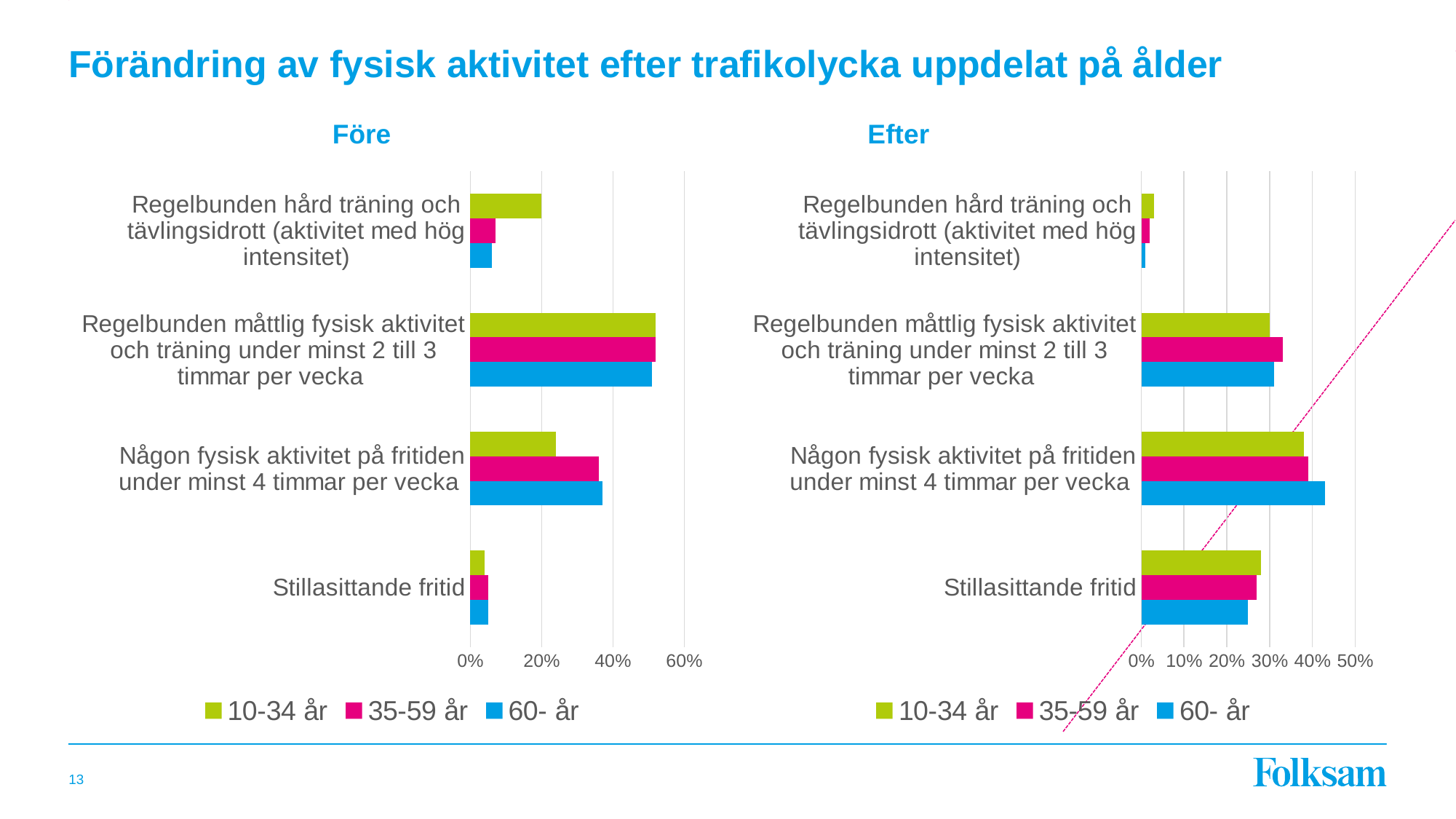
In the "Före" chart, which category has the lowest value for 10-34 år? Stillasittande fritid In the "Före" chart, which category has the highest value for 35-59 år? Regelbunden måttlig fysisk aktivitet och träning under minst 2 till 3 timmar per vecka How many categories are shown on the "Efter" chart? 4 How many series does the legend of the "Före" chart list? 3 In the "Före" chart, is the value for 60- år in "Regelbunden hård träning och tävlingsidrott (aktivitet med hög intensitet)" greater or less than 20%? less In the "Efter" chart, is the value for 10-34 år in "Regelbunden hård träning och tävlingsidrott (aktivitet med hög intensitet)" greater or less than 10%? less In the "Efter" chart, which age group has the highest value for "Någon fysisk aktivitet på fritiden under minst 4 timmar per vecka"? 60- år What are the legend entries of the "Efter" chart? 10-34 år, 35-59 år, 60- år In the "Före" chart, for "Någon fysisk aktivitet på fritiden under minst 4 timmar per vecka", which is larger: 10-34 år or 35-59 år? 35-59 år What kind of chart is the "Före" chart? bar chart In the "Efter" chart, is the value for 60- år in "Någon fysisk aktivitet på fritiden under minst 4 timmar per vecka" greater or less than 40%? greater